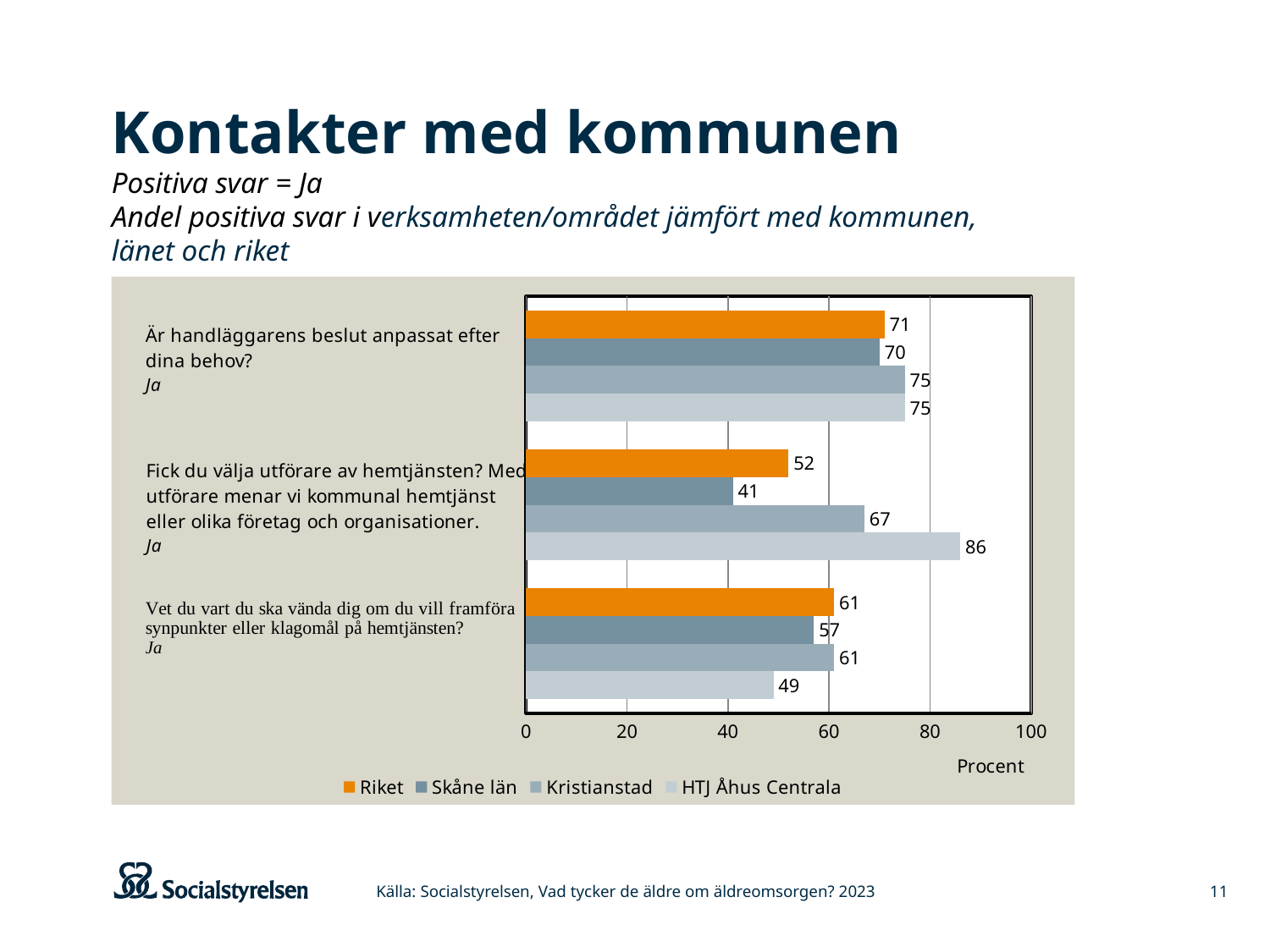
What is the difference between Kristianstad and Skåne län for the question 'Är handläggarens beslut anpassat efter dina behov?'? 5 What unit label is shown on the x axis of the chart? Procent Which series has the highest value for the question 'Fick du välja utförare av hemtjänsten?'? HTJ Åhus Centrala How many series does the legend list? 4 What is the value for Riket for the question 'Vet du vart du ska vända dig om du vill framföra synpunkter eller klagomål på hemtjänsten?'? 61 Which series has the lowest value for the question 'Fick du välja utförare av hemtjänsten?'? Skåne län What kind of chart is shown on the slide? bar chart How many question categories are plotted on the chart? 3 For the question 'Vet du vart du ska vända dig om du vill framföra synpunkter eller klagomål på hemtjänsten?', which is larger: Kristianstad or HTJ Åhus Centrala? Kristianstad What is the difference between HTJ Åhus Centrala and Riket for the question 'Fick du välja utförare av hemtjänsten?'? 34 What is the value for HTJ Åhus Centrala for the question 'Fick du välja utförare av hemtjänsten?'? 86 What is the value for Skåne län for the question 'Är handläggarens beslut anpassat efter dina behov?'? 70